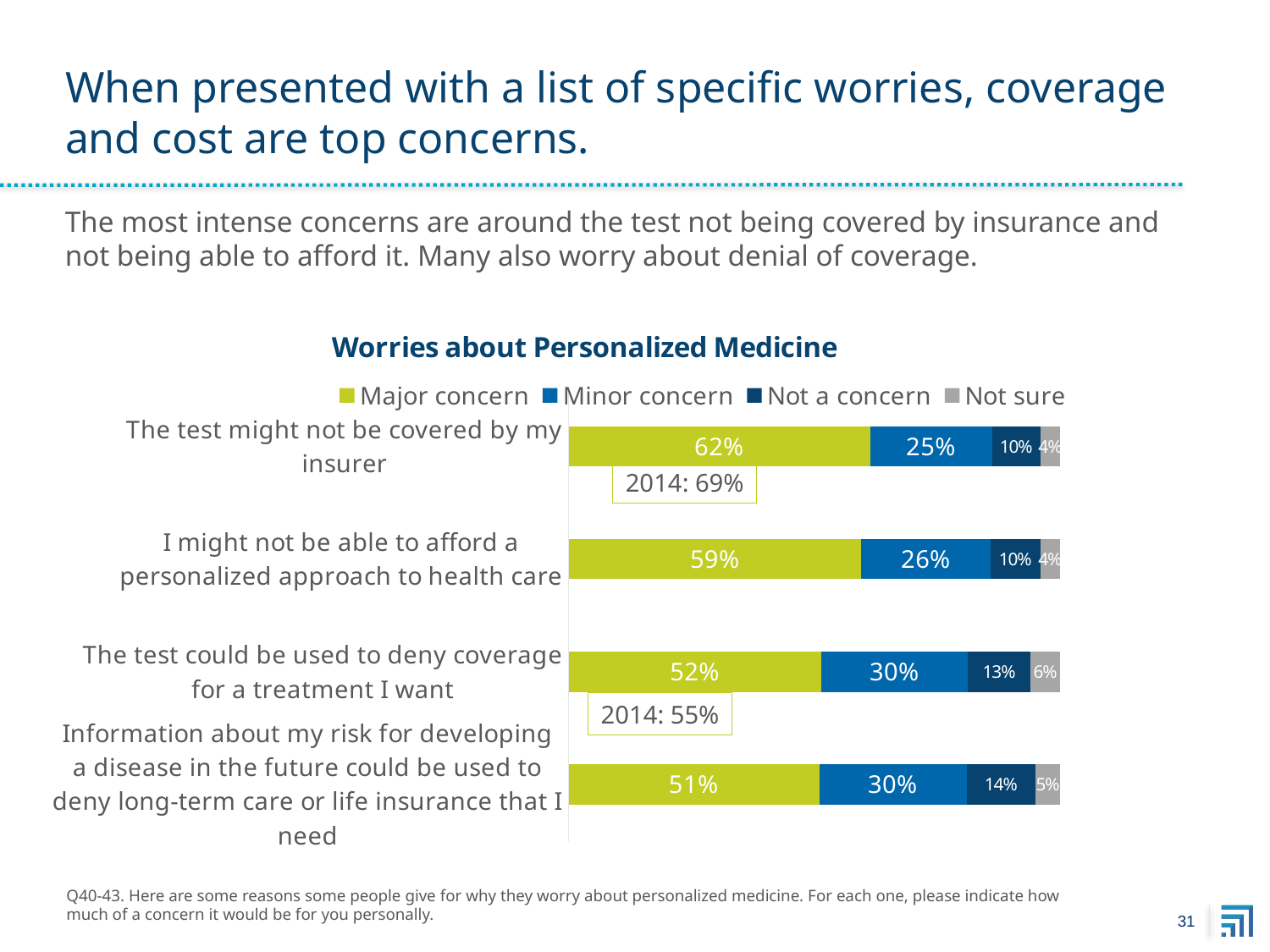
How many worries (categories) are shown in the chart? 4 Which has a larger 'Not a concern' share: 'The test could be used to deny coverage for a treatment I want' or 'I might not be able to afford a personalized approach to health care'? The test could be used to deny coverage for a treatment I want What is the difference in 'Major concern' percentage between 'The test might not be covered by my insurer' and 'The test could be used to deny coverage for a treatment I want'? 10 percentage points Which worry has the highest share of 'Major concern' responses? The test might not be covered by my insurer How many series does the legend list? 4 What type of chart is shown on the slide? Stacked bar chart What percentage say 'The test might not be covered by my insurer' is a major concern? 62% What percentage say 'The test could be used to deny coverage for a treatment I want' is not a concern? 13% Which worry has the lowest share of 'Major concern' responses? Information about my risk for developing a disease in the future could be used to deny long-term care or life insurance that I need What was the 2014 'Major concern' value noted for 'The test might not be covered by my insurer'? 69% What percentage are 'Not sure' about information about their risk for developing a disease being used to deny long-term care or life insurance? 5% What percentage say 'I might not be able to afford a personalized approach to health care' is a minor concern? 26%